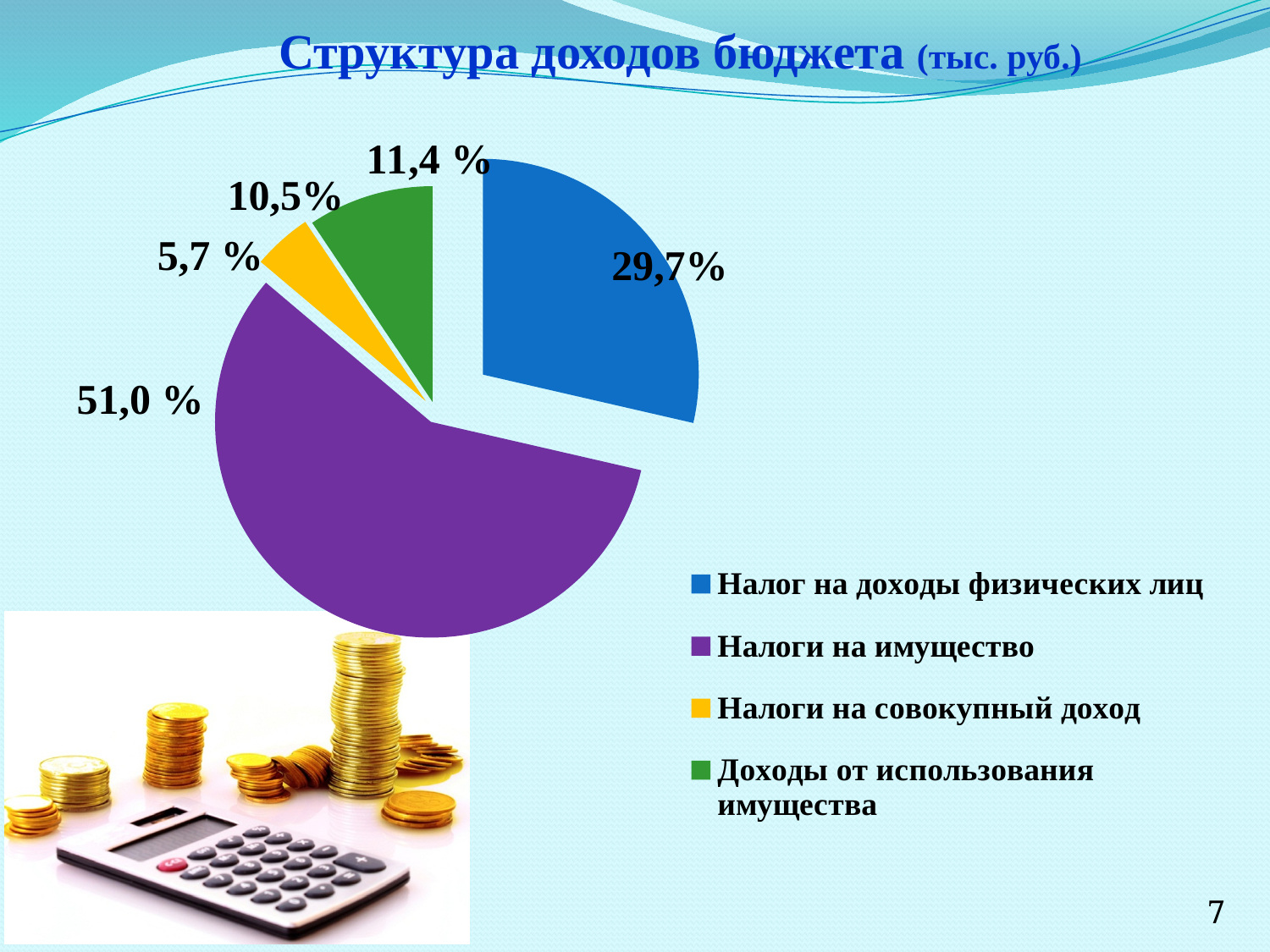
What kind of chart is shown on the slide? pie chart What is the title of the chart? Структура доходов бюджета (тыс. руб.) Which category has the largest slice of the pie? Налоги на имущество Which category has the smallest slice of the pie? Налоги на совокупный доход What share of the pie does "Налоги на имущество" have? 51,0 % How many categories does the legend of the pie chart list? 4 What colour is the slice for "Налоги на имущество"? purple By how many percentage points does "Налоги на имущество" exceed "Налог на доходы физических лиц"? 21,3 Which is larger: the slice for "Налог на доходы физических лиц" or the slice for "Доходы от использования имущества"? Налог на доходы физических лиц What is the value shown for "Налог на доходы физических лиц"? 29,7%